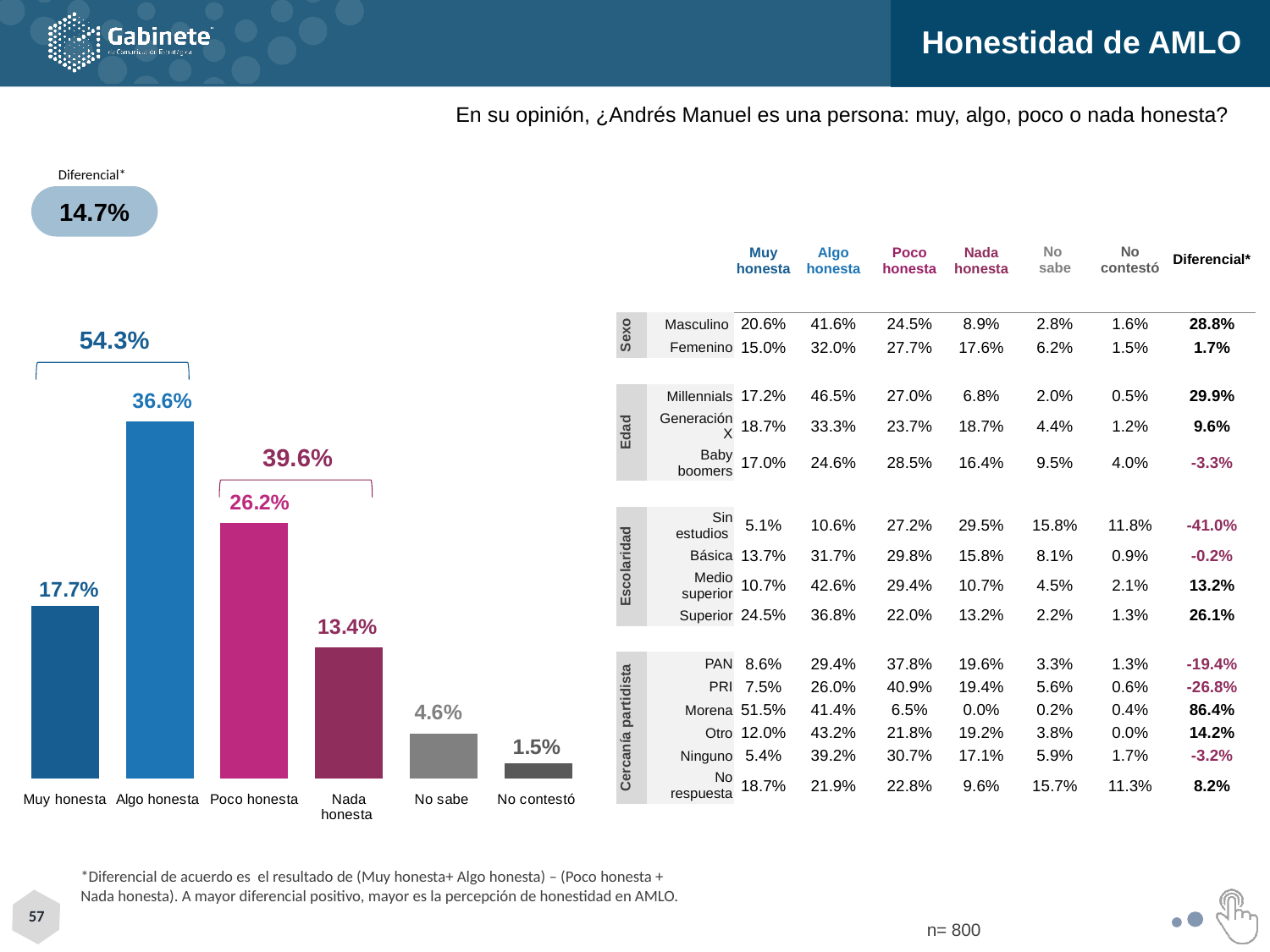
Which category has the highest value in the bar chart? Algo honesta What combined value does the bracket above "Muy honesta" and "Algo honesta" show in the bar chart? 54.3% What percentage of respondents answered "Algo honesta" in the bar chart? 36.6% What is the value shown for "Muy honesta" in the bar chart? 17.7% What kind of chart is shown on the left of the slide? Bar chart What is the difference between the "Algo honesta" and "Poco honesta" values in the bar chart? 10.4% What is the "Diferencial" value shown in the bubble above the bar chart? 14.7% What value does the bar chart show for "No contestó"? 1.5% Which is larger in the bar chart, "Muy honesta" or "Nada honesta"? Muy honesta What combined value does the bracket above "Poco honesta" and "Nada honesta" show in the bar chart? 39.6% How many categories are shown in the bar chart? 6 Which category has the lowest value in the bar chart? No contestó